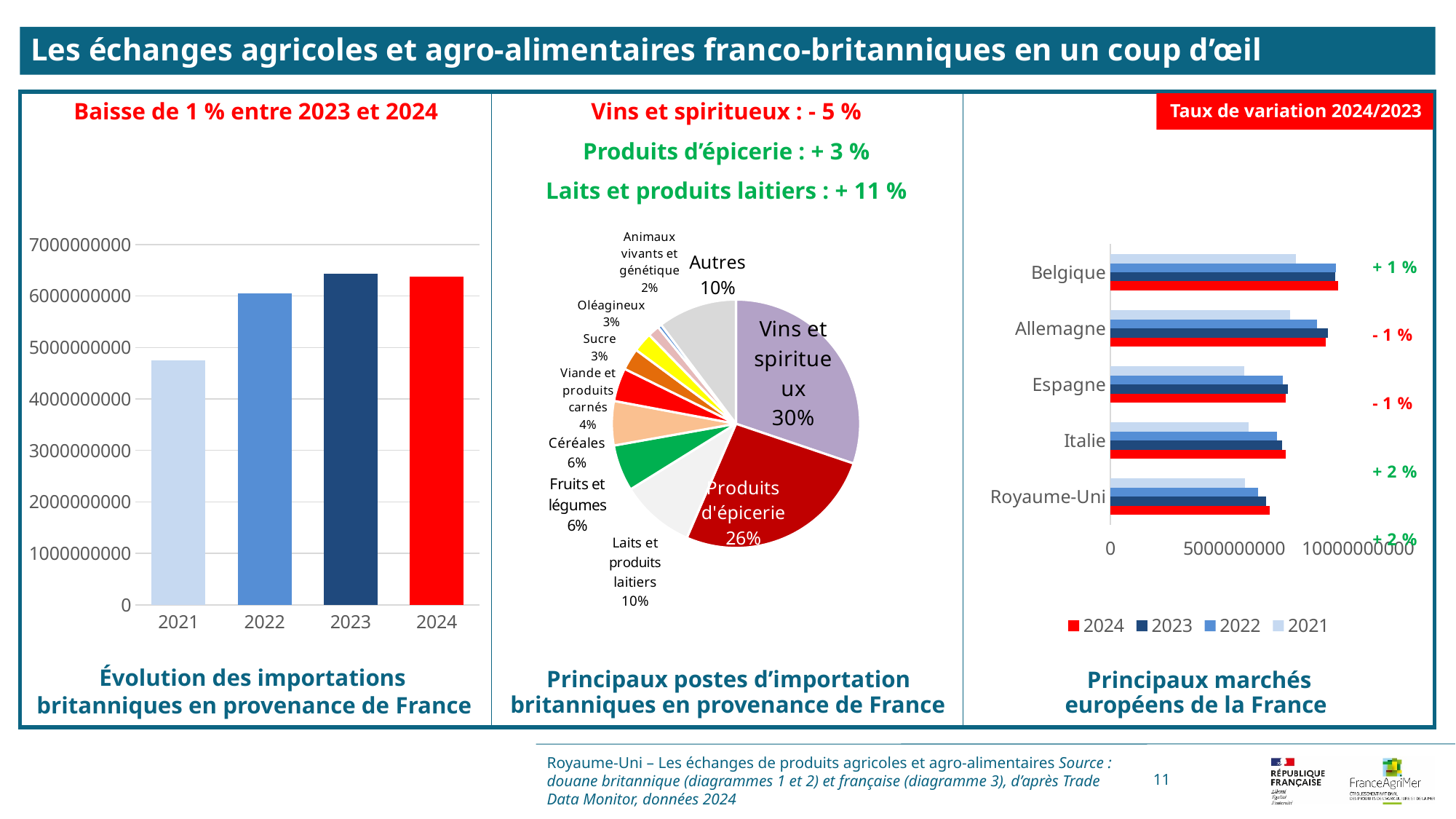
In the middle pie chart 'Principaux postes d'importation britanniques en provenance de France', which category has the largest share? Vins et spiritueux In the middle pie chart 'Principaux postes d'importation britanniques en provenance de France', what is the difference in percentage points between 'Vins et spiritueux' and 'Produits d'épicerie'? 4 In the middle pie chart 'Principaux postes d'importation britanniques en provenance de France', what is the percentage for 'Laits et produits laitiers'? 10% In the middle pie chart 'Principaux postes d'importation britanniques en provenance de France', what share does 'Vins et spiritueux' have? 30% In the left chart 'Évolution des importations britanniques en provenance de France', which year has the lowest value? 2021 In the right chart 'Principaux marchés européens de la France', which country has the highest value for 2024? Belgique In the left chart 'Évolution des importations britanniques en provenance de France', is the value for 2023 greater or less than 6000000000? greater In the left chart 'Évolution des importations britanniques en provenance de France', is the value for 2021 greater or less than 5000000000? less In the middle pie chart 'Principaux postes d'importation britanniques en provenance de France', which is larger: 'Céréales' or 'Viande et produits carnés'? Céréales What kind of chart is the left chart, 'Évolution des importations britanniques en provenance de France'? bar chart In the left chart 'Évolution des importations britanniques en provenance de France', how many years are plotted? 4 How many series does the legend of the right chart 'Principaux marchés européens de la France' list? 4